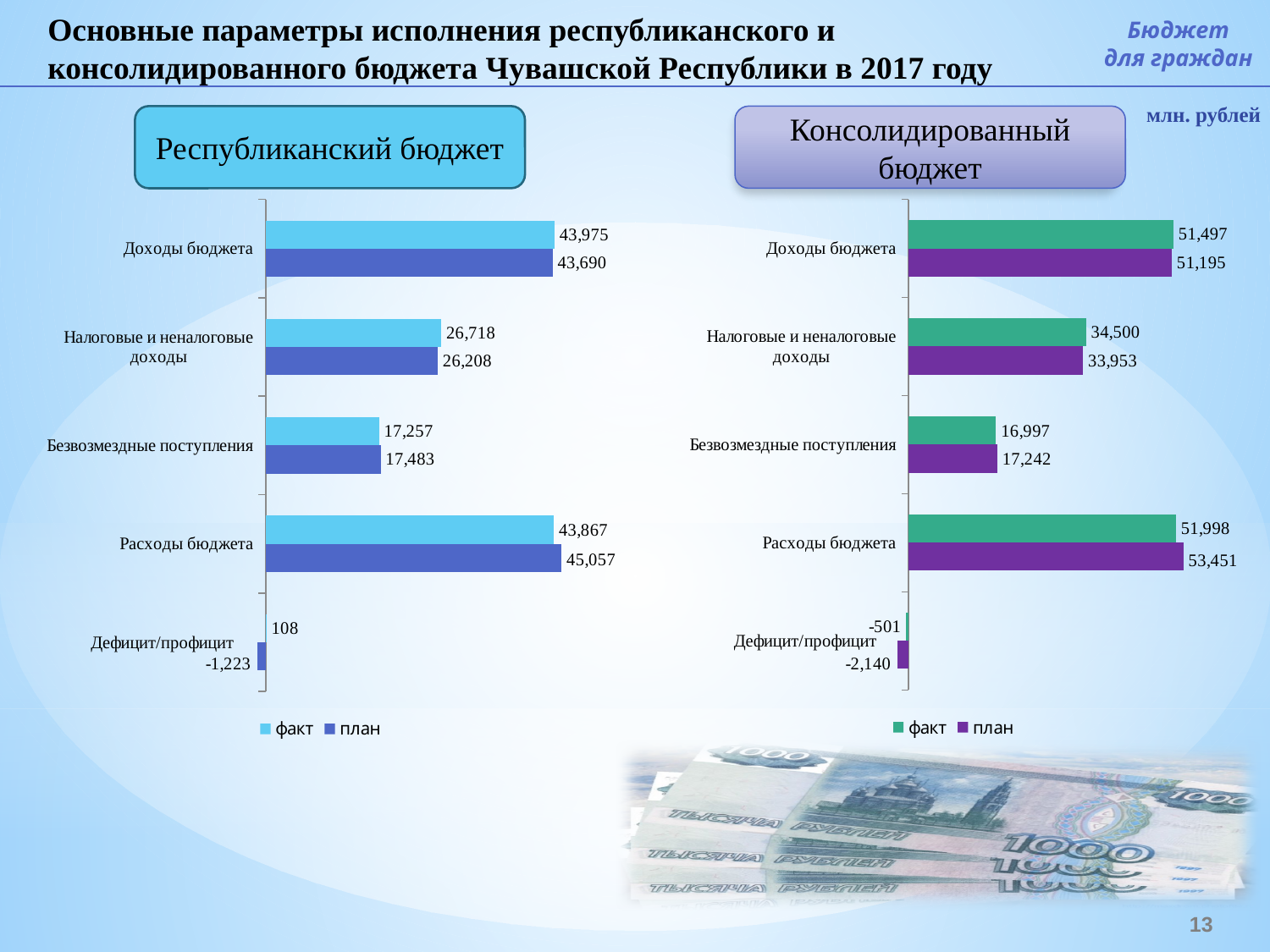
In the Консолидированный бюджет chart, what is the факт value for Налоговые и неналоговые доходы? 34,500 What type of chart is the Консолидированный бюджет chart? Bar chart In the Консолидированный бюджет chart, what is the план value for Дефицит/профицит? -2,140 In the Республиканский бюджет chart, which category has the lowest план value? Дефицит/профицит How many series does the legend of the Республиканский бюджет chart list? 2 How many categories are shown in the Консолидированный бюджет chart? 5 In the Консолидированный бюджет chart, which category has the highest план value? Расходы бюджета In the Республиканский бюджет chart, for Безвозмездные поступления, which is larger: факт or план? план In the Республиканский бюджет chart, what is the план value for Расходы бюджета? 45,057 In the Республиканский бюджет chart, what is the факт value for Доходы бюджета? 43,975 In the Консолидированный бюджет chart, what is the difference between the факт and план values for Доходы бюджета? 302 In the Республиканский бюджет chart, what is the difference between the план and факт values for Расходы бюджета? 1,190